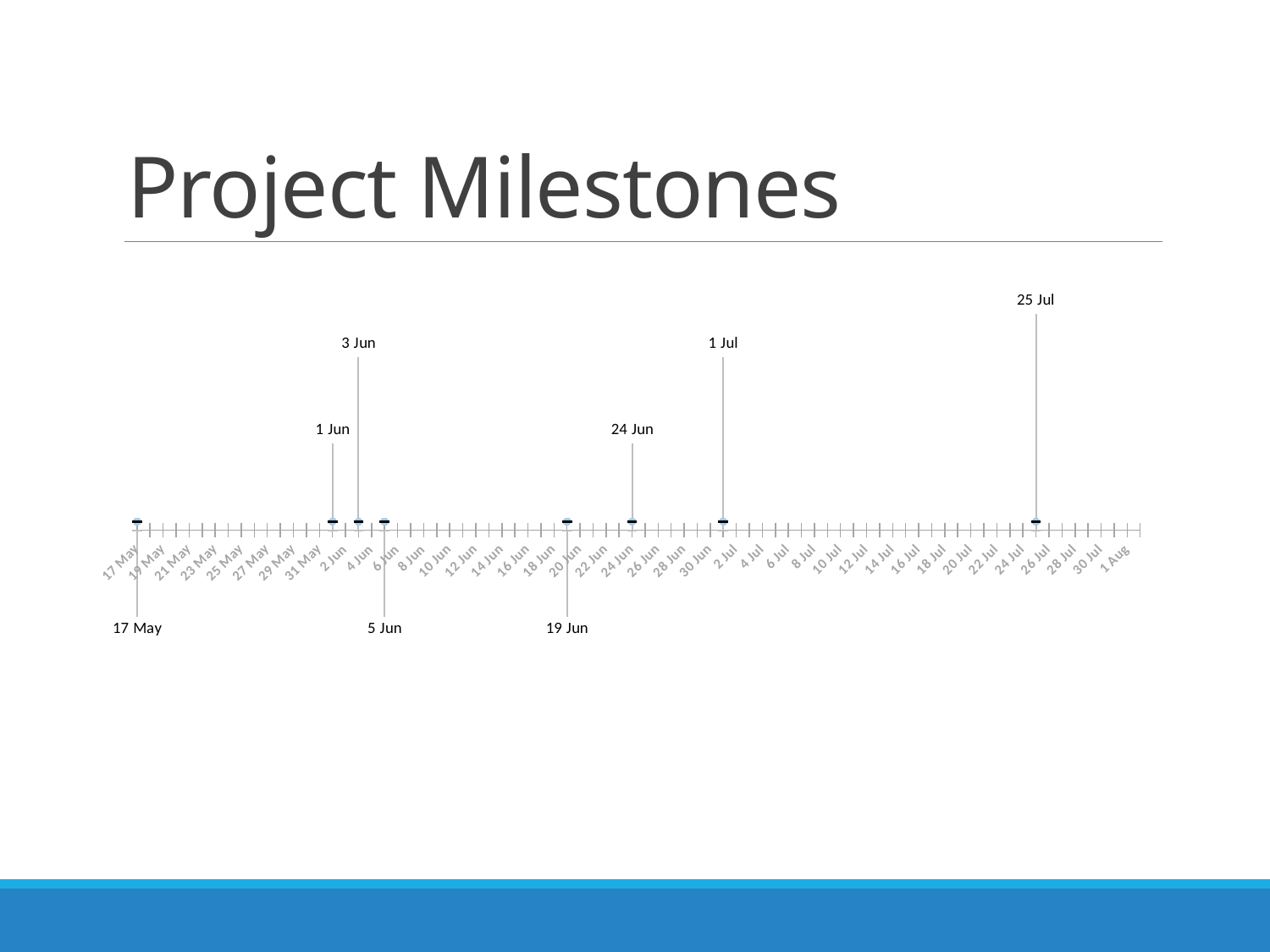
How many milestones on the timeline fall in July? 2 What is the earliest milestone date shown on the timeline? 17 May What kind of chart is shown on the slide? timeline How many milestones on the timeline fall in June? 5 What is the title of the slide containing the chart? Project Milestones How many milestones are marked on the timeline? 8 What is the last date label on the x axis of the timeline? 1 Aug What is the first date label on the x axis of the timeline? 17 May What is the latest milestone date shown on the timeline? 25 Jul Which milestone comes first on the timeline, 19 Jun or 24 Jun? 19 Jun Which milestone immediately follows 5 Jun on the timeline? 19 Jun Which milestone is later, 1 Jul or 25 Jul? 25 Jul